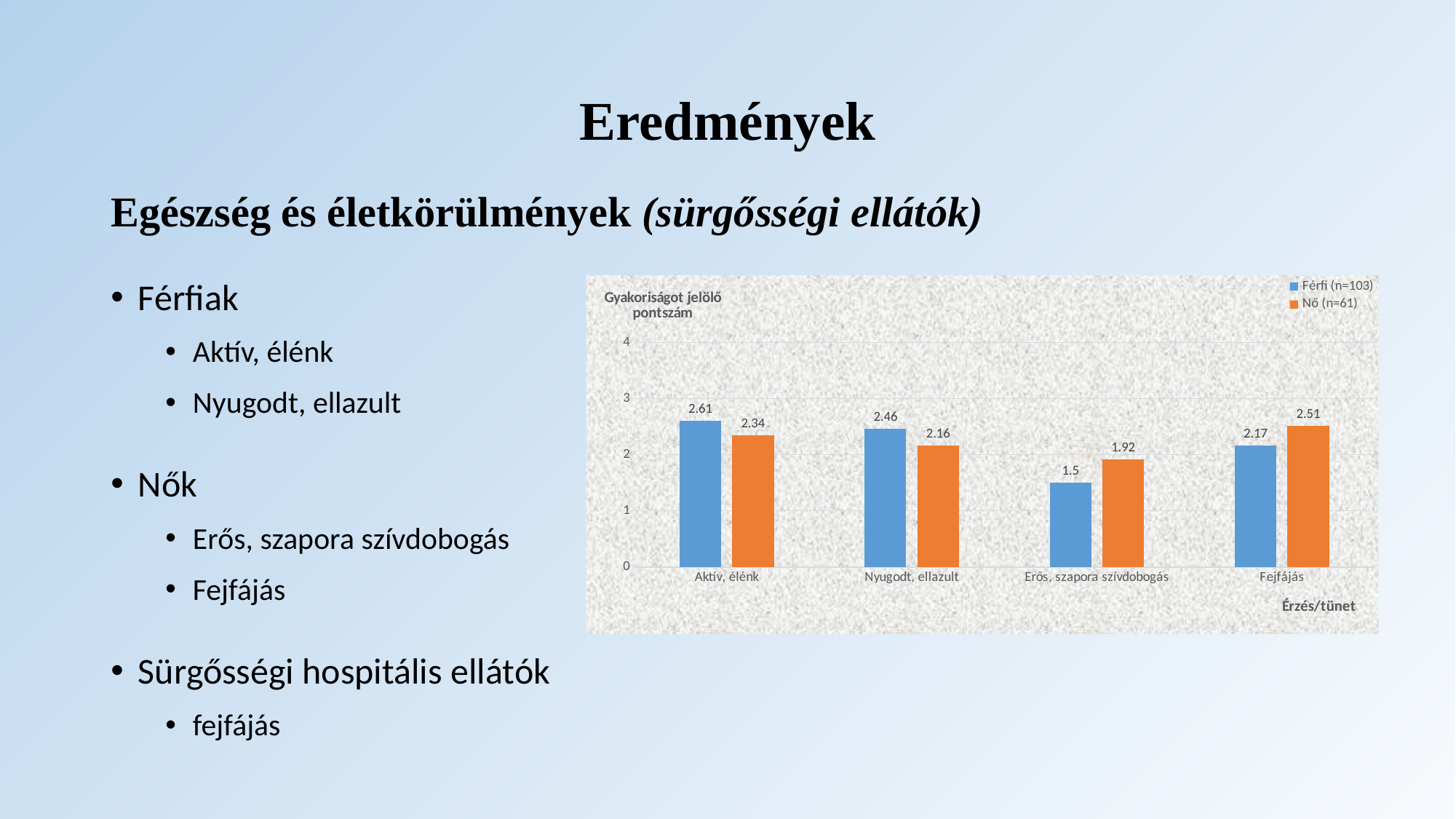
What is the value for Nő (n=61) in the Nyugodt, ellazult category? 2.16 What is the difference between the Férfi (n=103) and Nő (n=61) values in the Erős, szapora szívdobogás category? 0.42 What is the value for Férfi (n=103) in the Erős, szapora szívdobogás category? 1.5 Which category has the highest value for Férfi (n=103)? Aktív, élénk What kind of chart is shown on the slide? bar chart How many categories are shown on the x axis of the chart? 4 In the Fejfájás category, which series has the larger value, Férfi (n=103) or Nő (n=61)? Nő (n=61) Which category has the lowest value for Nő (n=61)? Erős, szapora szívdobogás What is the value for Férfi (n=103) in the Aktív, élénk category? 2.61 Is the value for Nő (n=61) in the Aktív, élénk category greater or less than 2? greater How many series does the chart legend list? 2 What is the value for Nő (n=61) in the Fejfájás category? 2.51